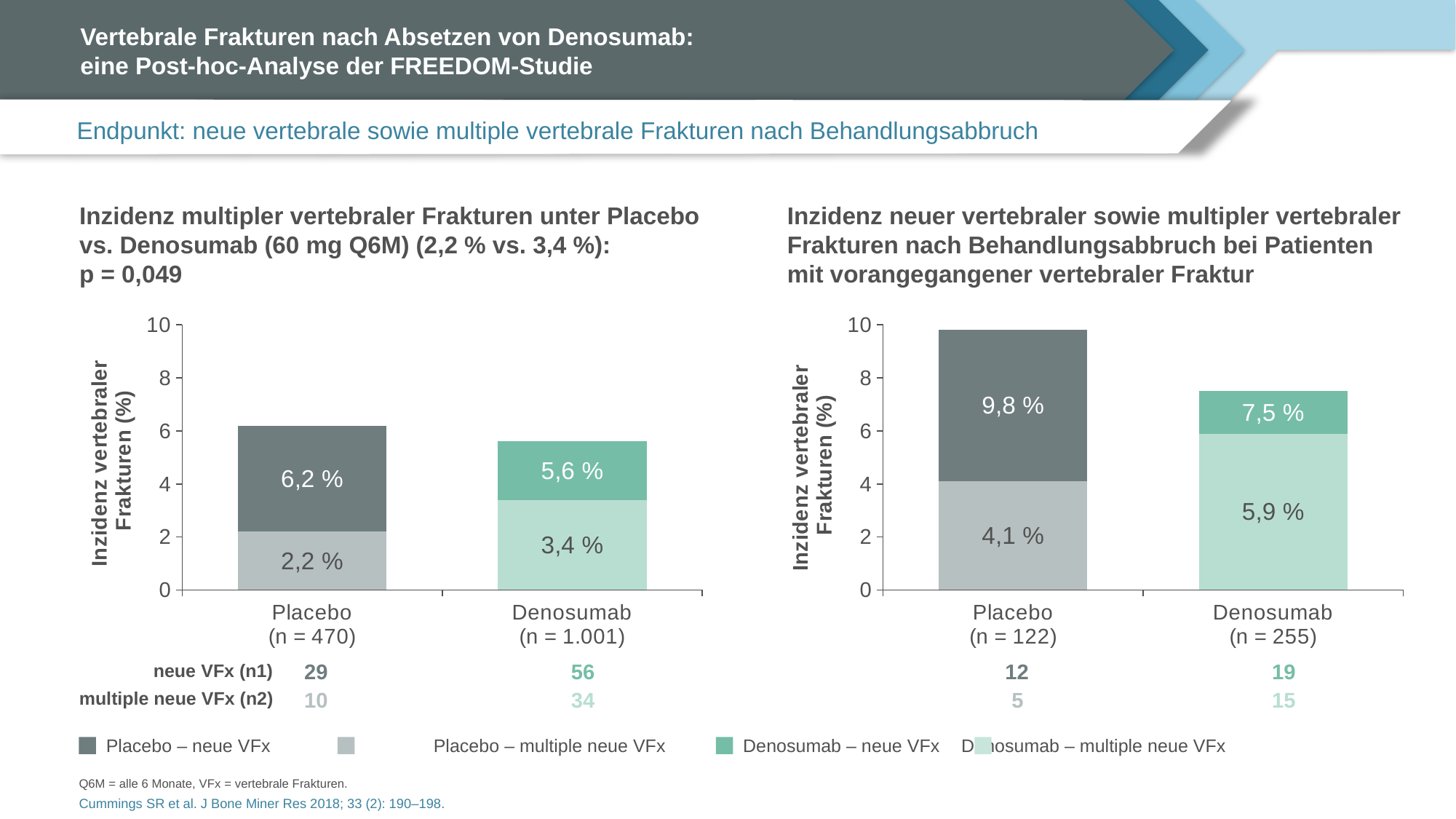
In the left chart, what is the incidence of multiple new vertebral fractures for Denosumab? 3,4 % In the left chart, what is the difference between the multiple new vertebral fracture incidence for Denosumab and for Placebo? 1,2 % In the right chart, what is the difference between the new vertebral fracture incidence for Placebo and for Denosumab? 2,3 % In the left chart, what is the incidence of new vertebral fractures (neue VFx) for Placebo? 6,2 % In the right chart, what is the incidence of multiple new vertebral fractures for Denosumab? 5,9 % In the right chart, is the new vertebral fracture incidence for Denosumab greater or less than 8? less In the right chart, which group has the higher incidence of new vertebral fractures, Placebo or Denosumab? Placebo What kind of chart is used on the right side of the slide? Bar chart How many treatment groups are shown on the x axis of the left chart? 2 In the left chart, which group has the higher incidence of multiple new vertebral fractures, Placebo or Denosumab? Denosumab In the right chart, what is the incidence of new vertebral fractures (neue VFx) for Placebo? 9,8 % How many entries does the legend at the bottom of the slide list? 4